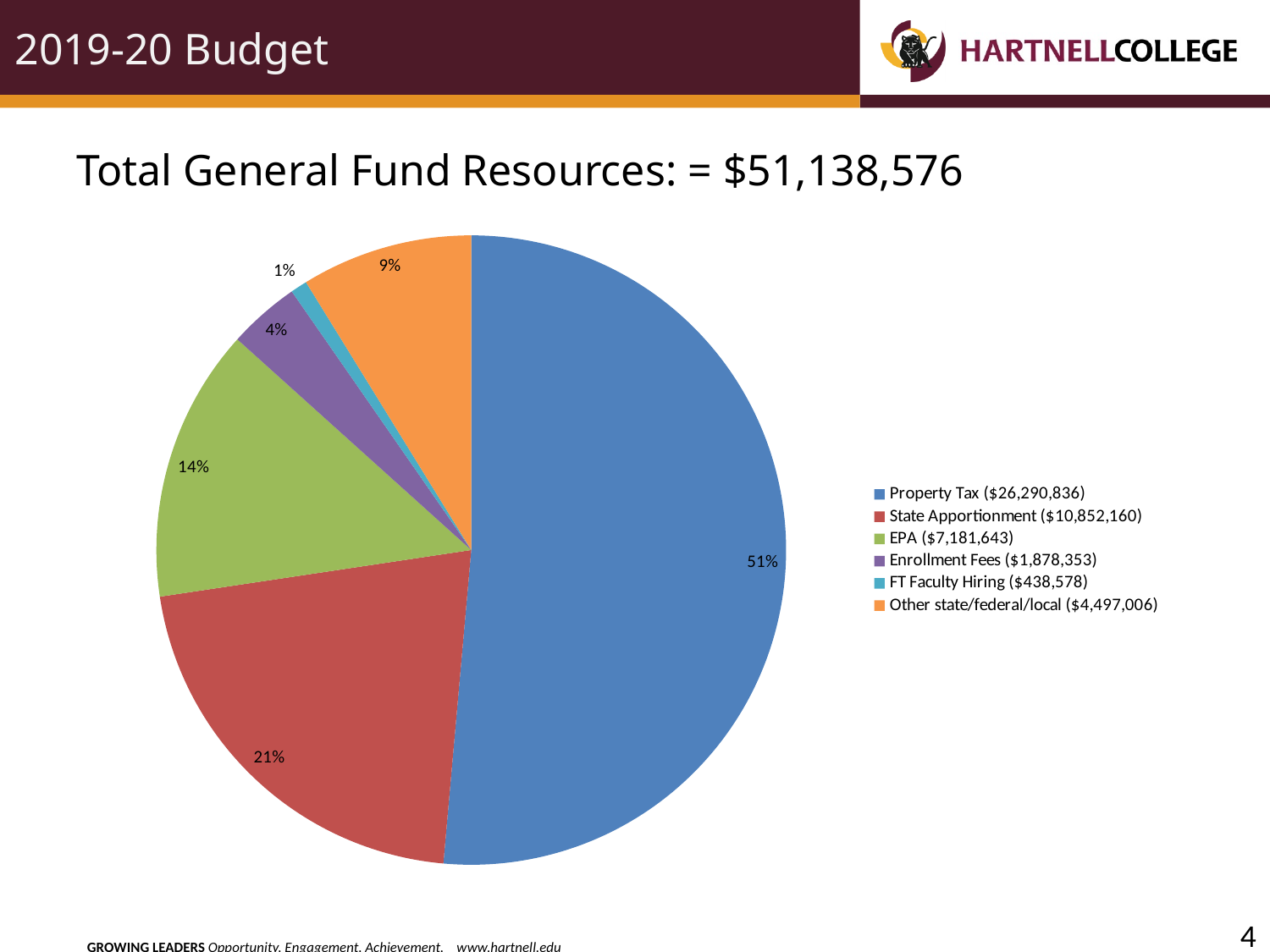
What share of the pie does State Apportionment represent? 21% What dollar amount does the legend give for Enrollment Fees? $1,878,353 Which category has the smallest slice of the pie? FT Faculty Hiring What is the difference in percentage points between the Property Tax share and the State Apportionment share? 30% What share of the pie does Other state/federal/local represent? 9% Which is larger, the EPA slice or the Other state/federal/local slice? EPA What share of the pie does Property Tax represent? 51% What kind of chart is shown on the slide? pie chart Which category has the largest slice of the pie? Property Tax How many categories does the legend list? 6